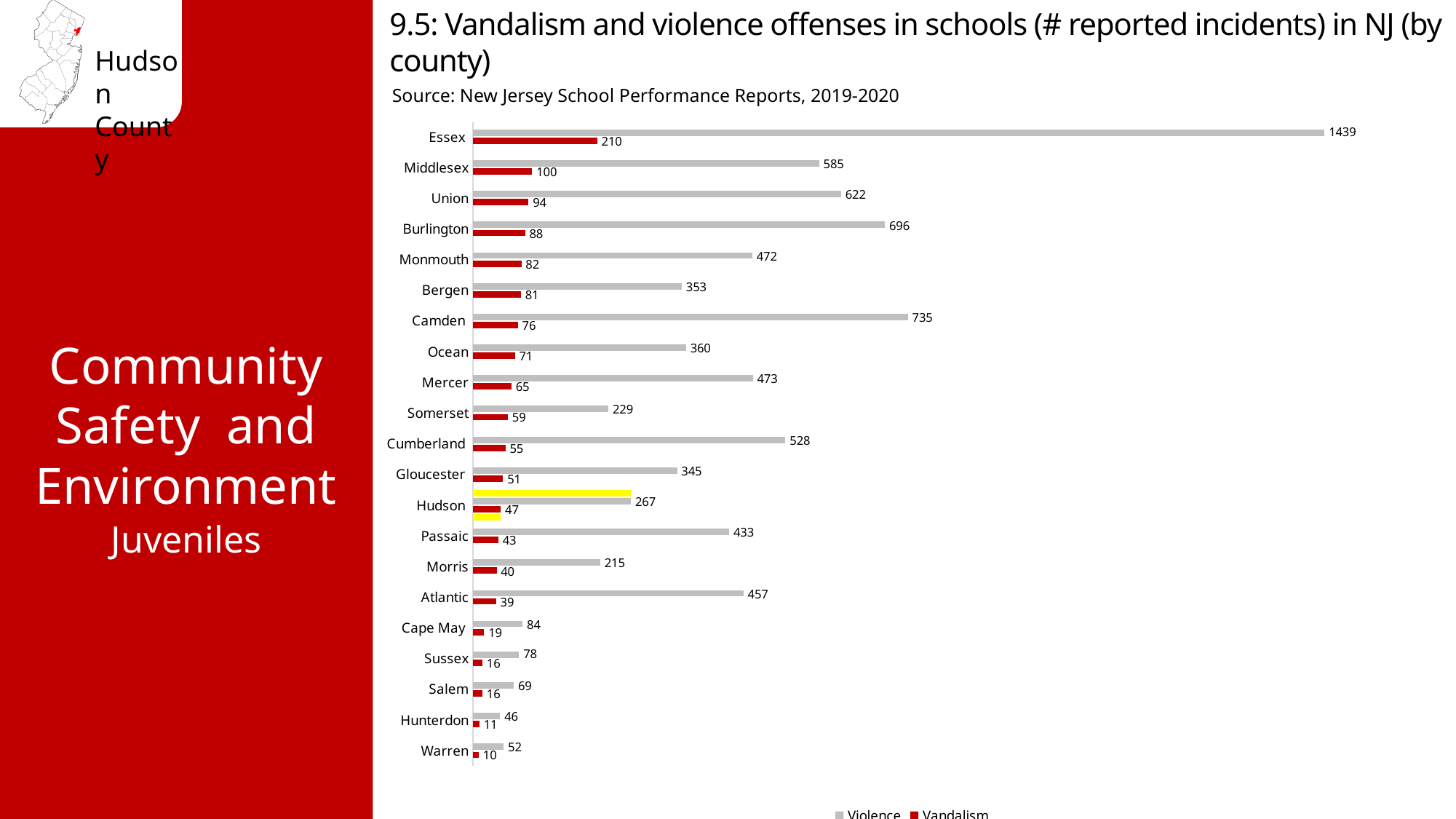
How many series does the legend list? 2 What is the number of reported violence incidents for Hudson County? 267 Which county has more violence incidents, Union or Burlington? Burlington Which county has the lowest number of violence incidents? Hunterdon How many counties are shown in the chart? 21 What is the violence value for Camden? 735 What is the difference between the violence values for Essex and Middlesex? 854 What type of chart is shown on the slide? Bar chart Which county has the lowest number of vandalism incidents? Warren What is the number of reported vandalism incidents for Hudson County? 47 Which county has the highest number of violence incidents? Essex What is the difference between the vandalism values for Essex and Hudson? 163